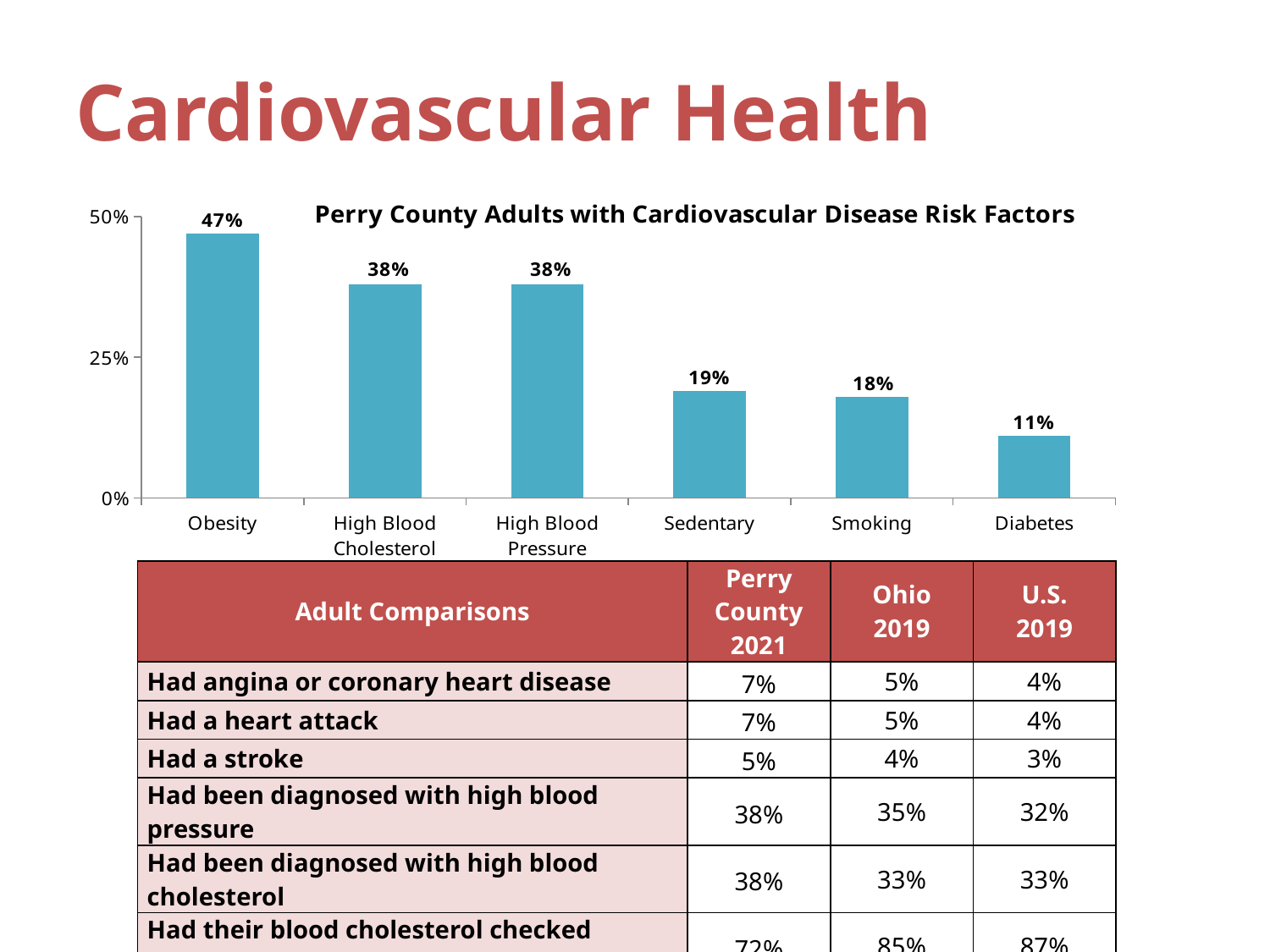
Which risk factor has the highest value in the chart? Obesity Which risk factor has the lowest value in the chart? Diabetes What is the title of the chart? Perry County Adults with Cardiovascular Disease Risk Factors What is the value for Diabetes in the chart? 11% What kind of chart is shown on the slide? bar chart How many risk factor categories are shown in the chart? 6 What is the value for Sedentary in the chart? 19% Is the value for Sedentary greater or less than 25%? less What is the difference between the values for High Blood Pressure and Diabetes? 27% Which is larger, the value for Obesity or the value for High Blood Cholesterol? Obesity What is the value for Obesity in the chart? 47% What is the difference between the values for Obesity and Smoking? 29%